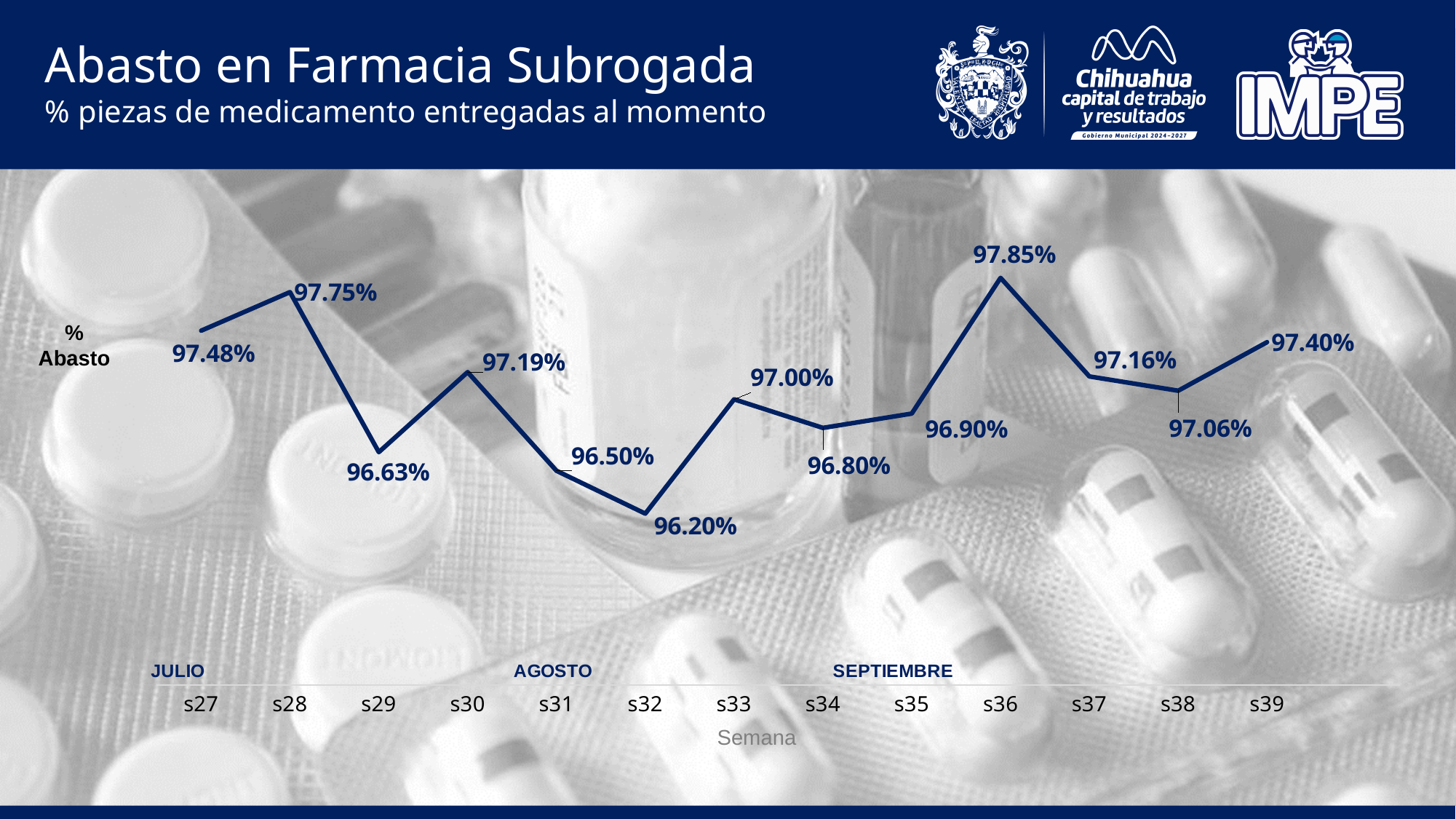
What is the % Abasto value for week s27? 97.48% What is the difference between the % Abasto values for s34 and s35? 0.10% Which week has the lowest % Abasto value? s32 What is the % Abasto value for week s39? 97.40% Which week has a larger % Abasto value, s28 or s30? s28 What type of chart is shown on the slide? line chart Does the % Abasto value rise or fall from s31 to s32? fall What is the % Abasto value for week s32? 96.20% What is the difference between the % Abasto values for s36 and s32? 1.65% How many weeks are plotted on the chart? 13 Which week has the highest % Abasto value? s36 What is the label of the x axis of the chart? Semana